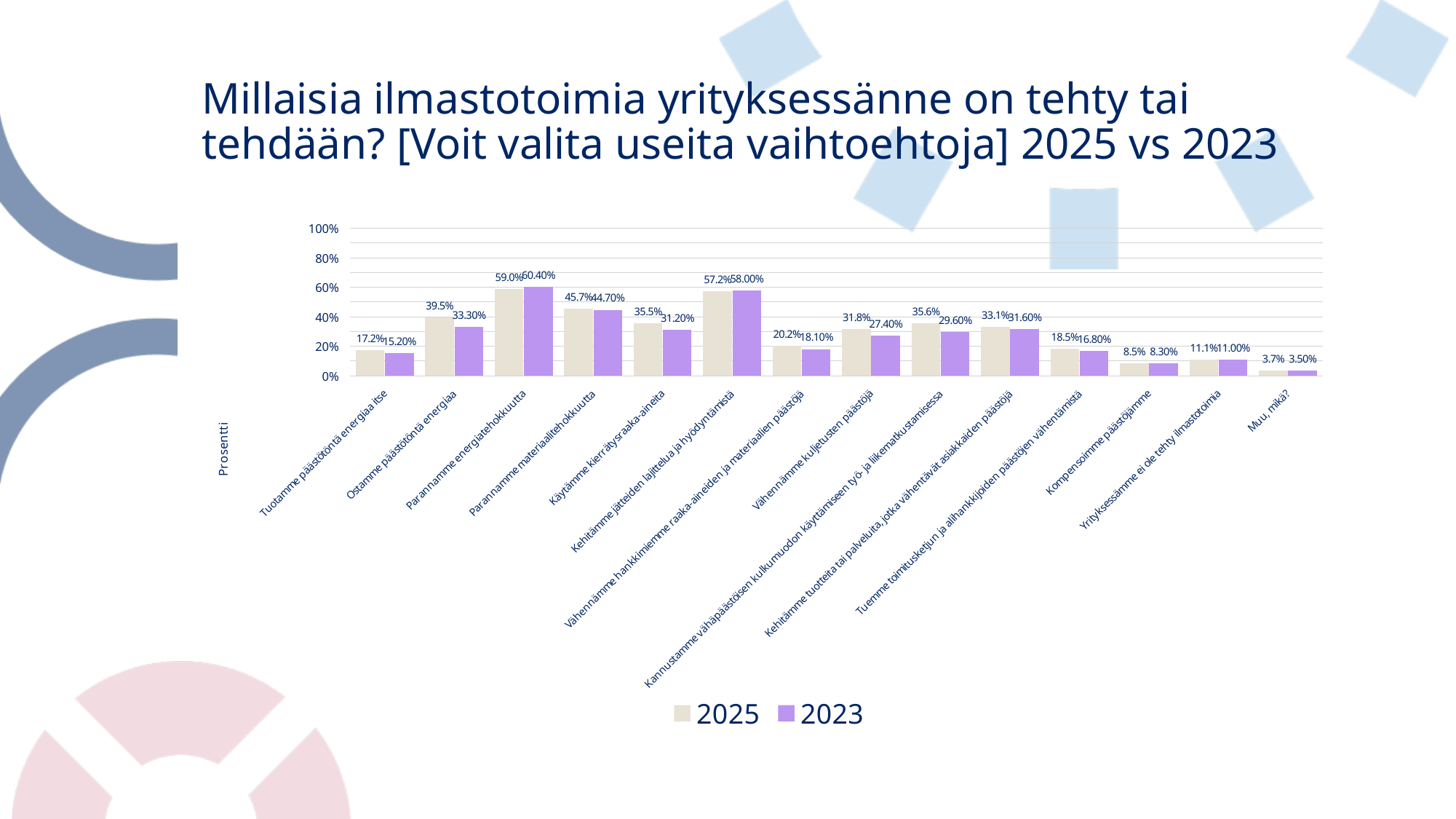
What is the 2025 value for 'Kompensoimme päästöjämme'? 8.5% What is the 2023 value for 'Vähennämme kuljetusten päästöjä'? 27.40% What label is shown on the vertical axis? Prosentti What type of chart is shown on the slide? Bar chart Is the 2025 value for 'Parannamme materiaalitehokkuutta' greater or less than 40%? greater Which category has the highest 2025 value? Parannamme energiatehokkuutta What is the difference between the 2025 and 2023 values for 'Ostamme päästötöntä energiaa'? 6.2 percentage points How many categories are shown on the x axis? 14 How many series does the legend list? 2 For 'Parannamme energiatehokkuutta', which series has the larger value, 2025 or 2023? 2023 What is the 2025 value for 'Parannamme energiatehokkuutta'? 59.0% Which category has the lowest 2023 value? Muu, mikä?